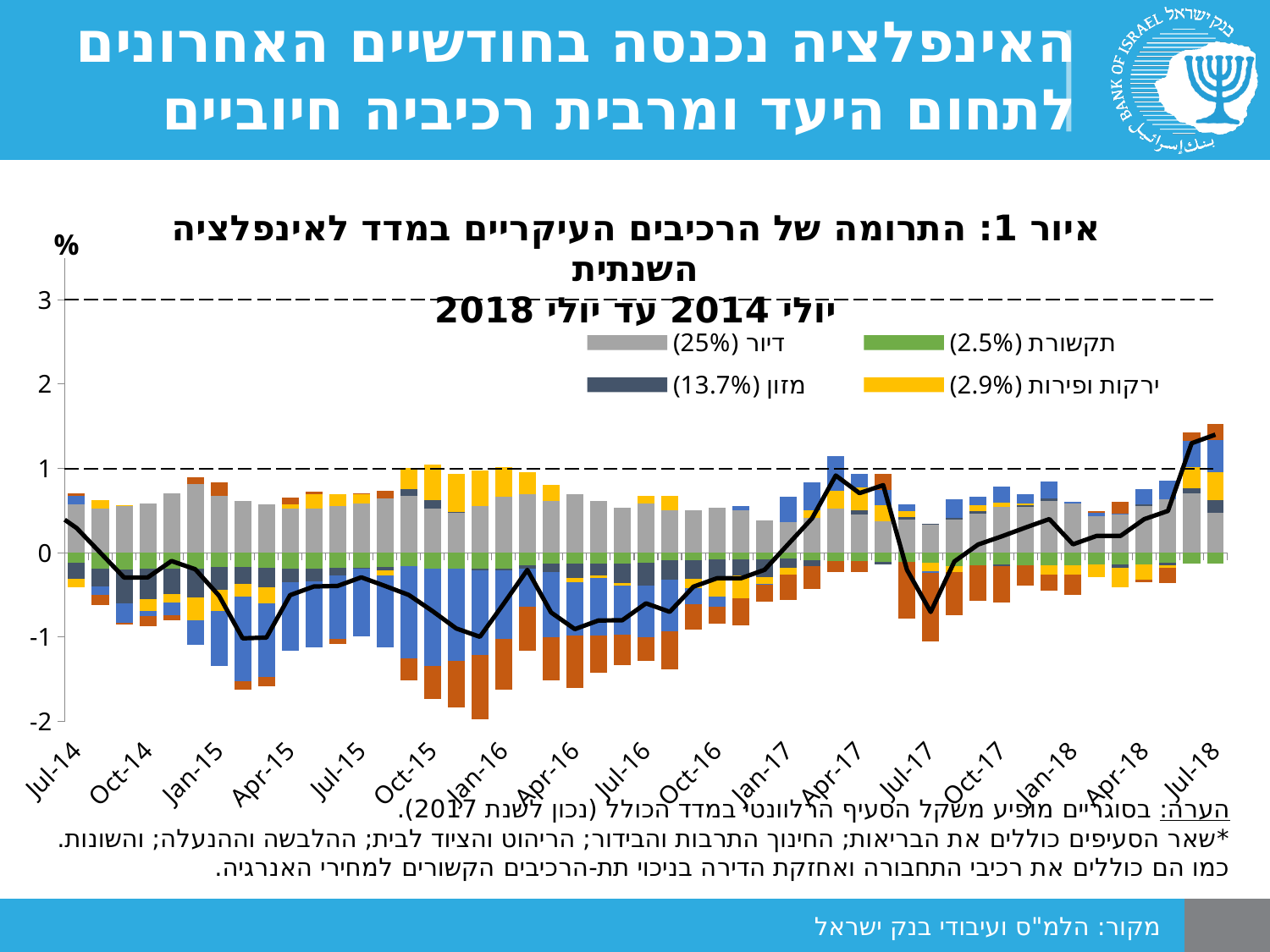
What kind of chart is shown on the slide? Stacked bar chart with a line Which is larger, the value of the line at Apr-17 or at Jul-17? Apr-17 Which is larger, the value of the line at Jul-18 or at Jul-17? Jul-18 Is the value of the line at Apr-17 greater or less than 0? greater Is the value of the line at Jul-18 greater or less than 1? greater What is the highest value shown on the vertical axis? 3 Does the line rise or fall between Jan-18 and Jul-18? rise Is the value of the line at Jul-14 greater or less than 1? less What weight is shown in the legend for מזון? 13.7% How many series does the visible legend list? 4